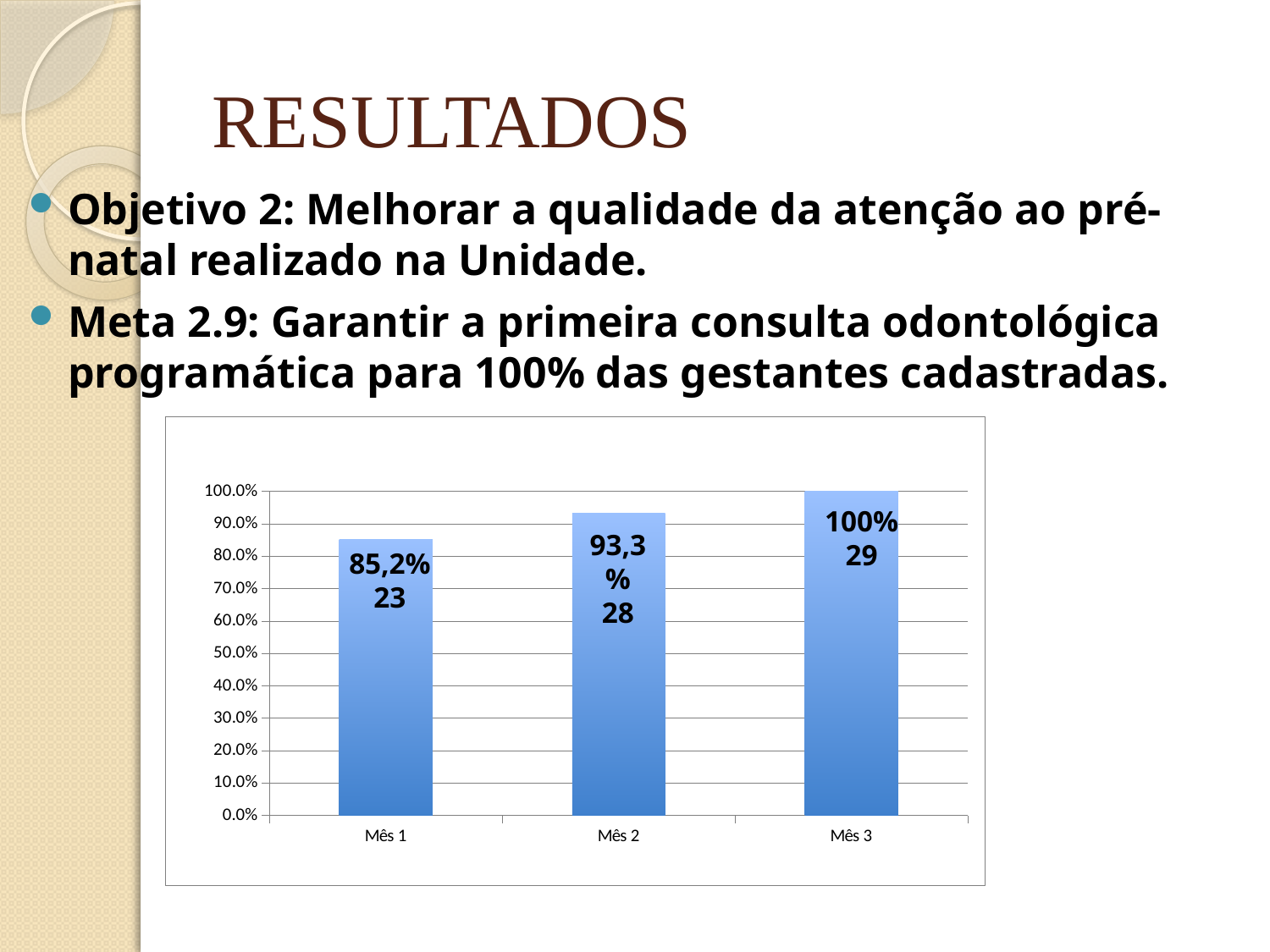
What percentage is shown for Mês 2? 93,3% What count is printed on the bar for Mês 2? 28 What kind of chart is shown on the slide? Bar chart What is the difference in percentage points between Mês 3 and Mês 1? 14,8 Which month has the highest percentage? Mês 3 Which is larger, the value for Mês 2 or the value for Mês 1? Mês 2 What is the difference between the counts printed for Mês 3 and Mês 1? 6 What percentage is shown for Mês 3? 100% What percentage is shown for Mês 1? 85,2% Do the values rise or fall from Mês 1 to Mês 3? Rise Which month has the lowest percentage? Mês 1 How many months (categories) are shown on the x axis? 3